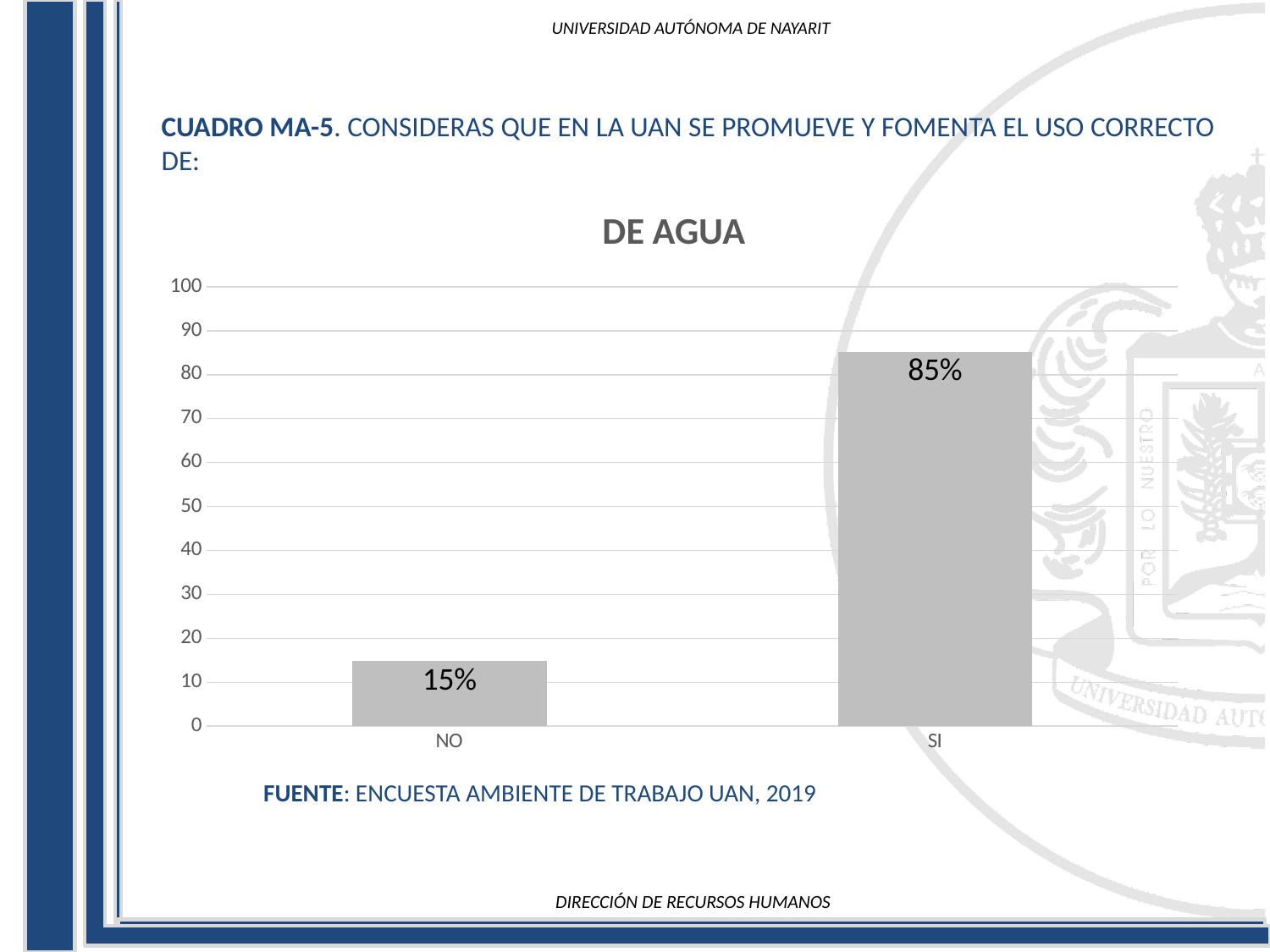
What is the title of the chart? DE AGUA What is the highest value shown on the y axis? 100 Which is larger, the value for NO or the value for SI? SI Is the value for SI greater or less than 80? greater What is the value for SI? 85% What is the difference between the values for SI and NO? 70% How many categories are shown on the x axis? 2 What kind of chart is shown? bar chart Which category has the highest value? SI Is the value for NO greater or less than 20? less Which category has the lowest value? NO What is the value for NO? 15%